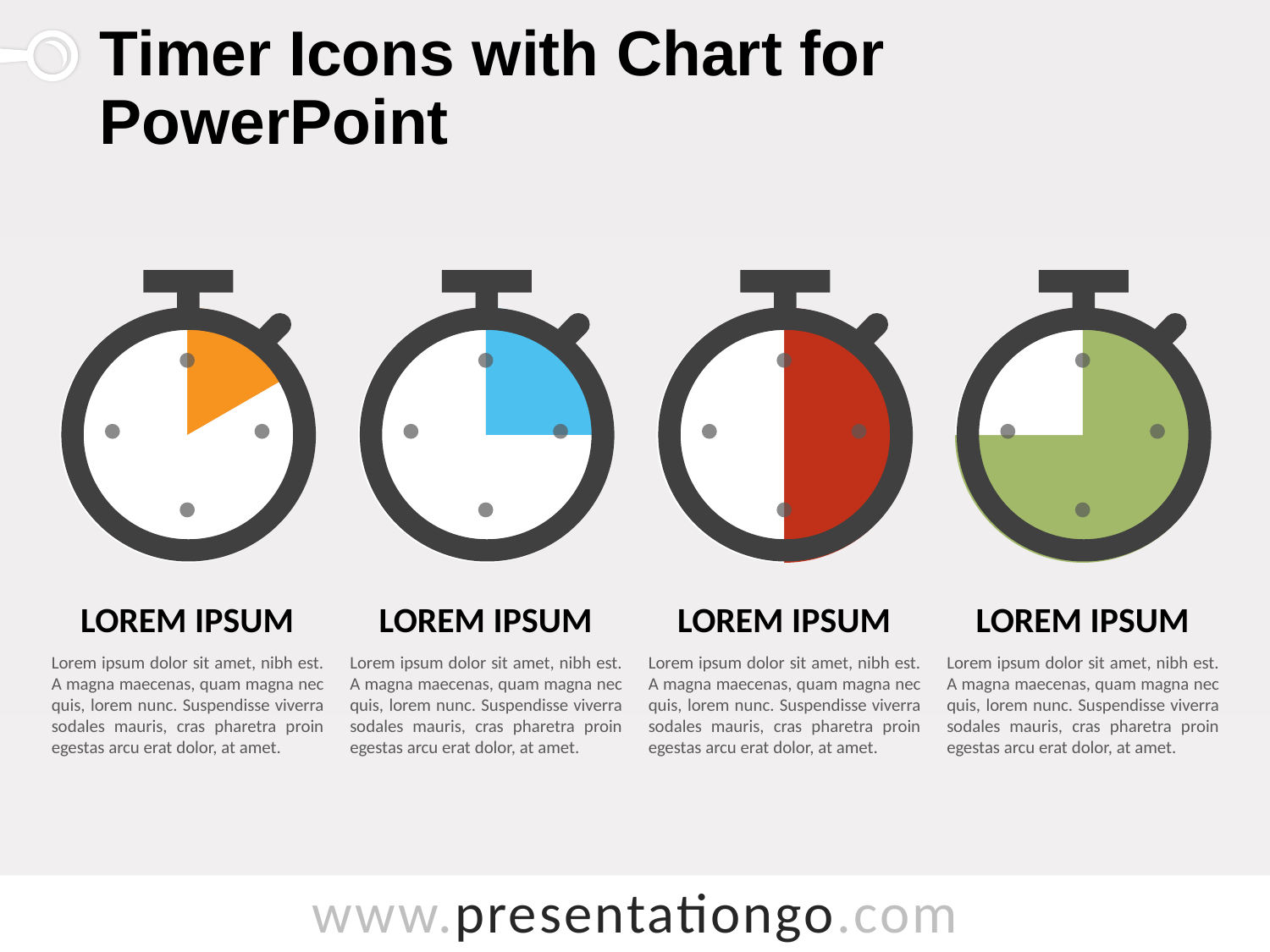
Do the filled portions of the timers increase or decrease from left to right across the slide? Increase What colour is the filled portion of the third timer? Red Which has a larger filled portion, the second (blue) timer or the third (red) timer? The third (red) timer Which timer has the largest filled portion of its dial? The fourth (green) timer How many timer icons are shown on the slide? 4 What colour is the filled portion of the second timer? Blue Which timer has the smallest filled portion of its dial? The first (orange) timer Which has a larger filled portion, the first (orange) timer or the fourth (green) timer? The fourth (green) timer